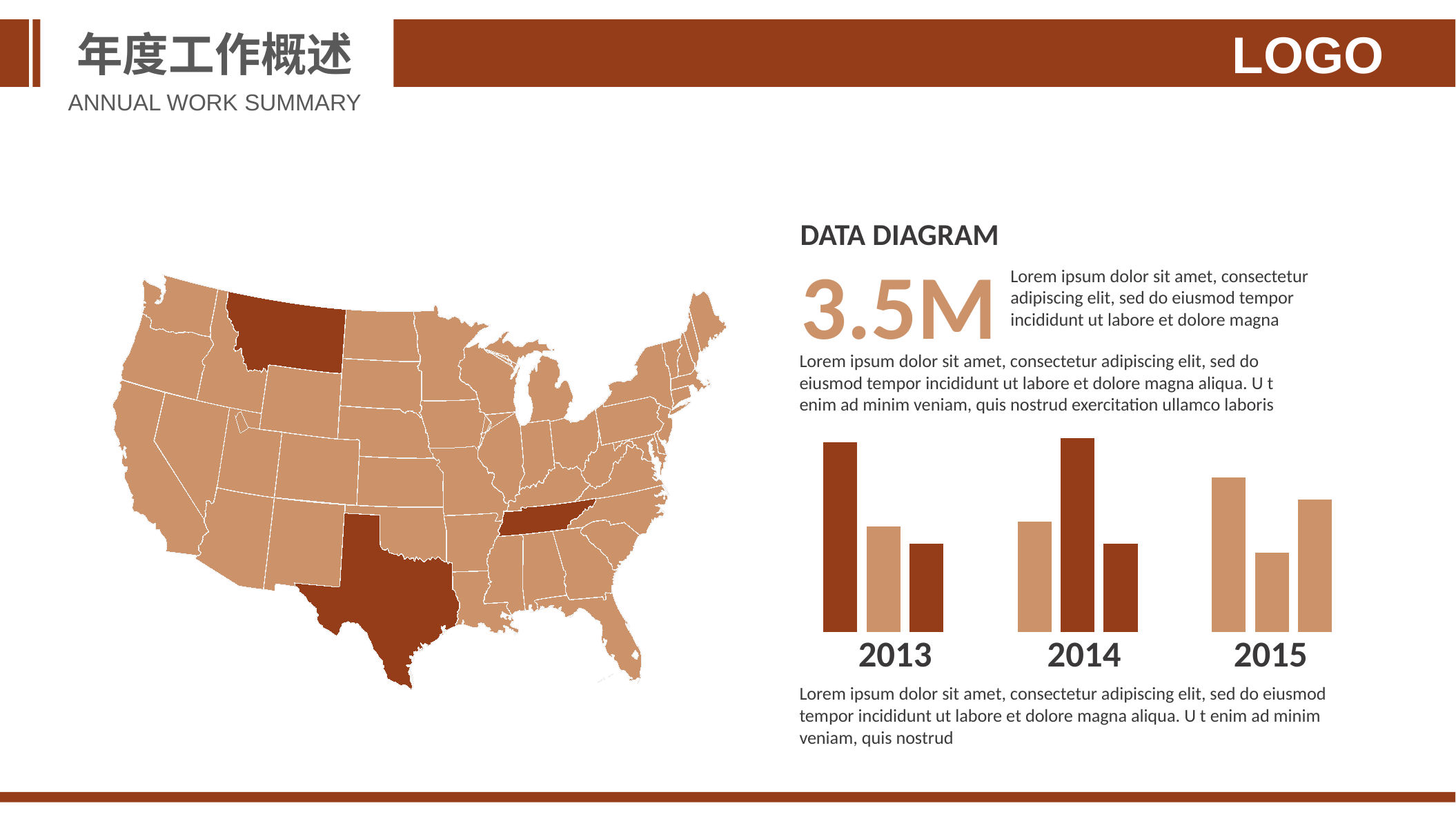
How many bars are drawn in each year group of the bar chart? 3 How many year categories are shown on the x axis of the bar chart? 3 Which years are labelled on the x axis of the bar chart? 2013, 2014, 2015 What kind of chart is shown under the DATA DIAGRAM heading? bar chart How many bars are there in total in the bar chart? 9 Does the bar chart display a legend? No In the 2015 group of the bar chart, is the left bar or the right bar taller? left In the 2015 group of the bar chart, which bar is the shortest: the left, middle or right one? middle In the 2014 group of the bar chart, is the left bar or the right bar taller? left In the 2013 group of the bar chart, which bar is the tallest: the left, middle or right one? left In the 2013 group of the bar chart, which bar is the shortest: the left, middle or right one? right In the 2014 group of the bar chart, which bar is the tallest: the left, middle or right one? middle